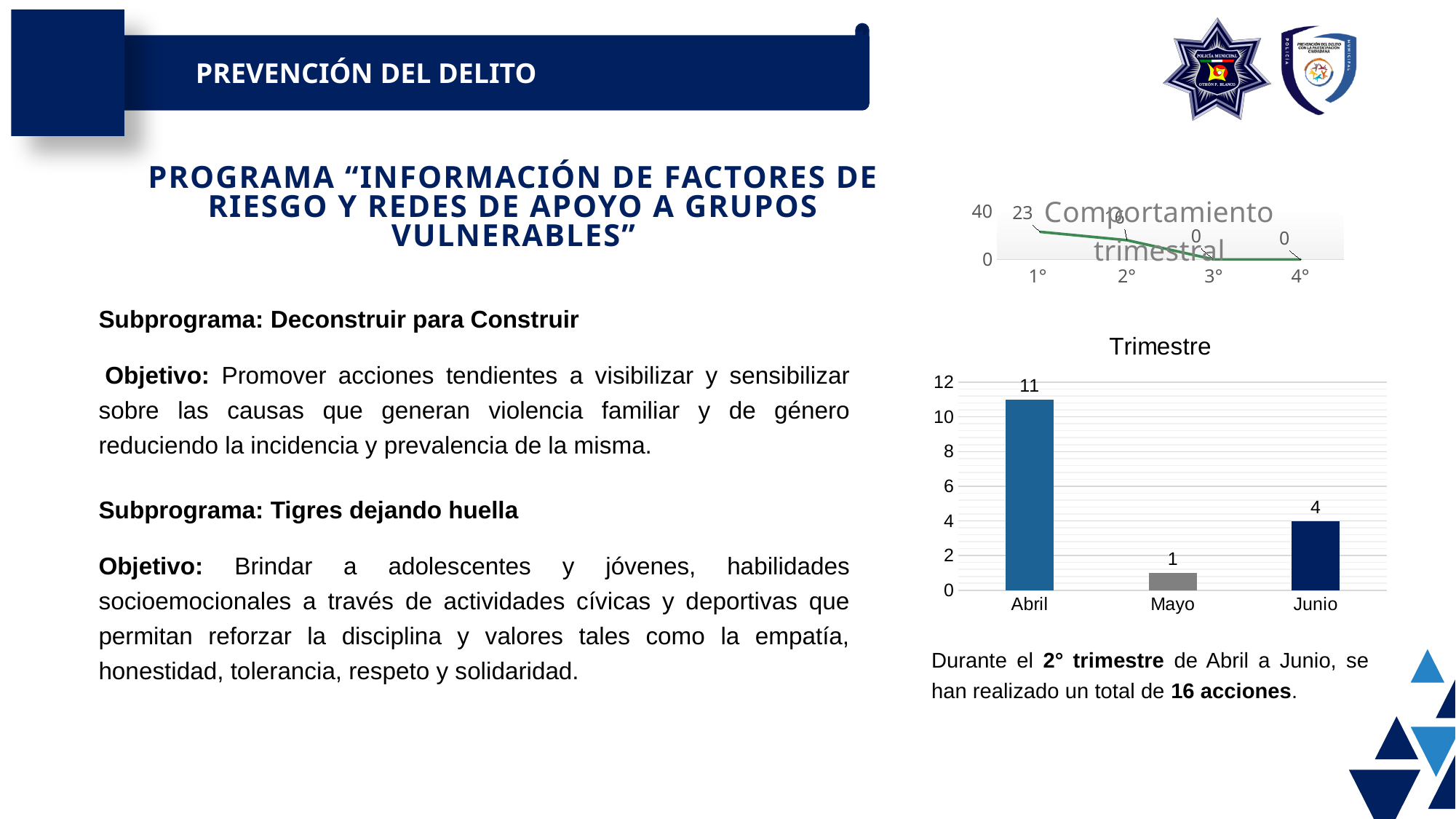
What kind of chart is the 'Trimestre' chart? Bar chart In the 'Trimestre' bar chart, which month has the highest value? Abril In the 'Comportamiento trimestral' line chart, what is the value for 1°? 23 In the 'Comportamiento trimestral' line chart, what is the value for 4°? 0 In the 'Trimestre' bar chart, what is the value for Abril? 11 In the 'Trimestre' bar chart, what is the difference between the values for Abril and Junio? 7 In the 'Trimestre' bar chart, what is the value for Junio? 4 In the 'Trimestre' bar chart, what is the value for Mayo? 1 In the 'Comportamiento trimestral' line chart, do the values rise or fall from 1° to 4°? Fall In the 'Trimestre' bar chart, which is larger, the value for Junio or the value for Mayo? Junio In the 'Trimestre' bar chart, which month has the lowest value? Mayo In the 'Trimestre' bar chart, how many months are shown on the x axis? 3